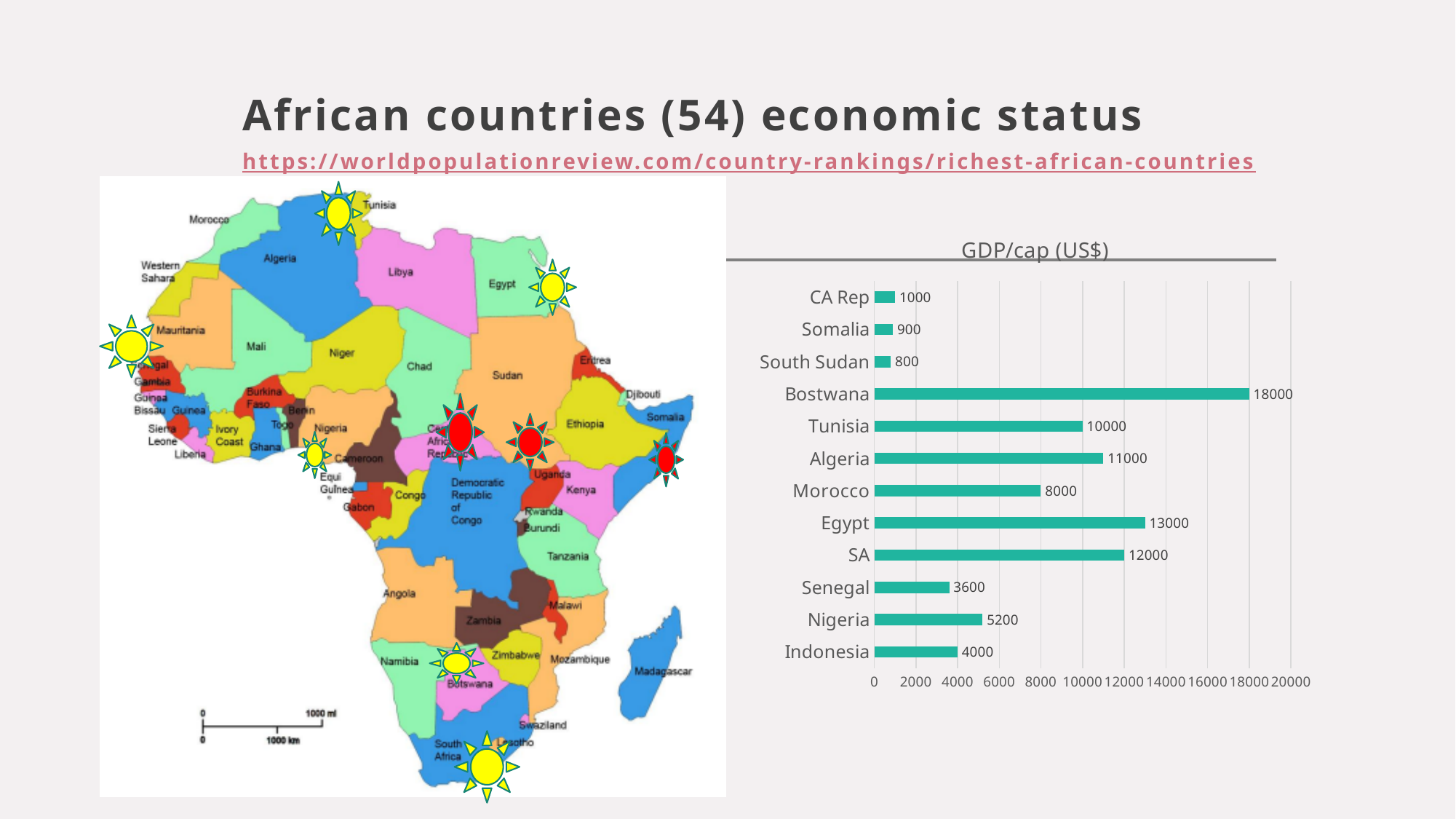
What is the GDP/cap (US$) value for Somalia? 900 What is the GDP/cap (US$) value for Bostwana? 18000 What is the difference in GDP/cap (US$) between Egypt and Morocco? 5000 Which has a higher GDP/cap (US$), Algeria or Tunisia? Algeria What kind of chart is the GDP/cap (US$) chart? bar chart Which country has the lowest GDP/cap (US$) in the chart? South Sudan Which country has the highest GDP/cap (US$) in the chart? Bostwana What is the title of the chart on the slide? GDP/cap (US$) Is the GDP/cap (US$) value for SA greater or less than 10000? greater What is the GDP/cap (US$) value for Nigeria? 5200 How many countries are shown in the GDP/cap (US$) chart? 12 What is the difference in GDP/cap (US$) between Senegal and Indonesia? 400